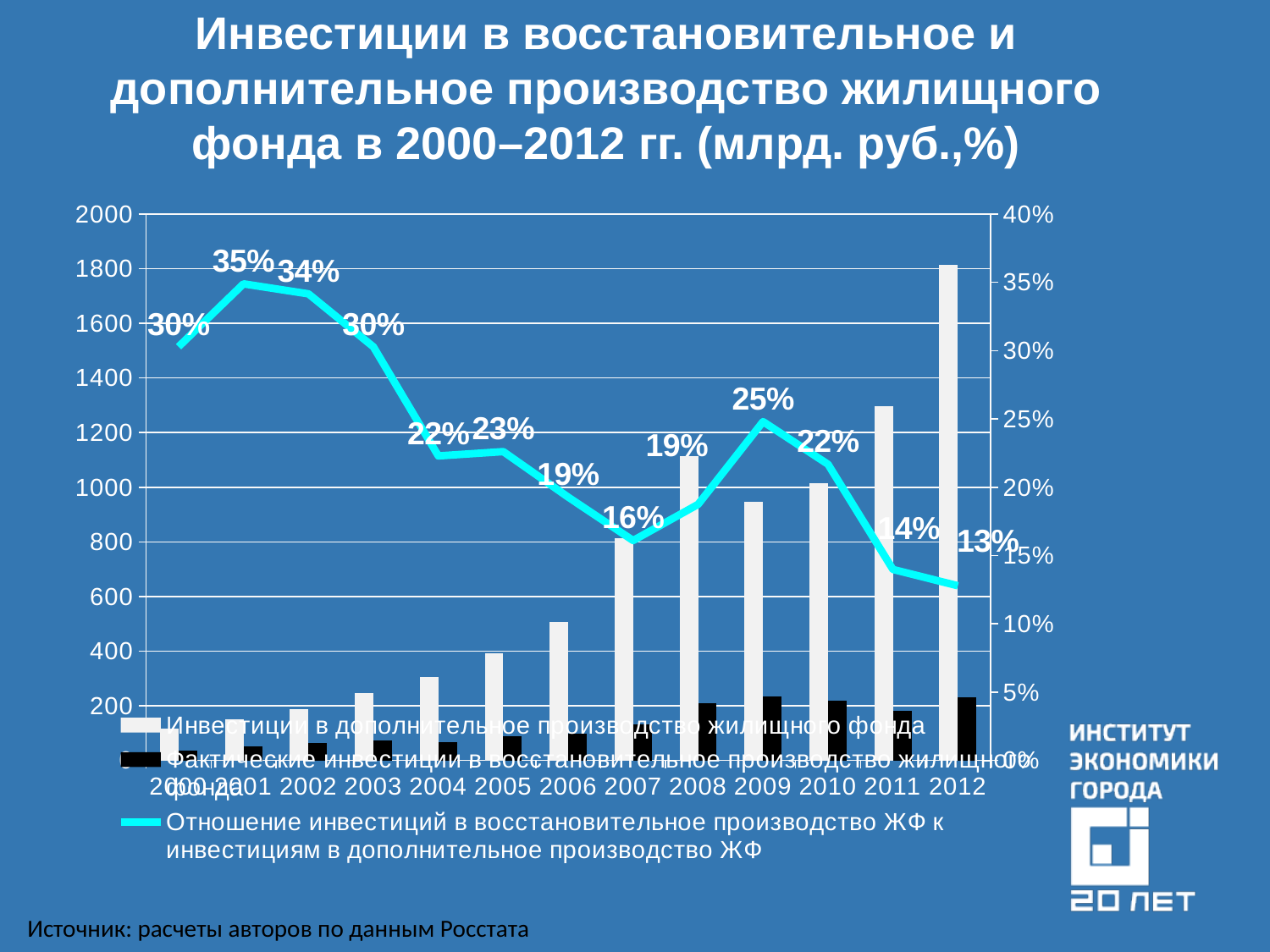
What is the difference between the ratio values for 2001 and 2012? 22 percentage points How many years are shown on the x axis? 13 How many series does the legend list? 3 Is the value of the white bar (investments in additional housing production) for 2012 greater or less than 1600? greater Is the value of the white bar (investments in additional housing production) for 2006 greater or less than 600? less What is the ratio value shown for 2012 on the line series? 13% In which year does the ratio line reach its lowest value? 2012 What is the overall trend of the ratio line from 2001 to 2012? falling What is the ratio value shown for 2001 on the line series? 35% In which year does the ratio line reach its highest value? 2001 What is the ratio value shown for 2009 on the line series? 25% Which year has a higher ratio value, 2005 or 2007? 2005